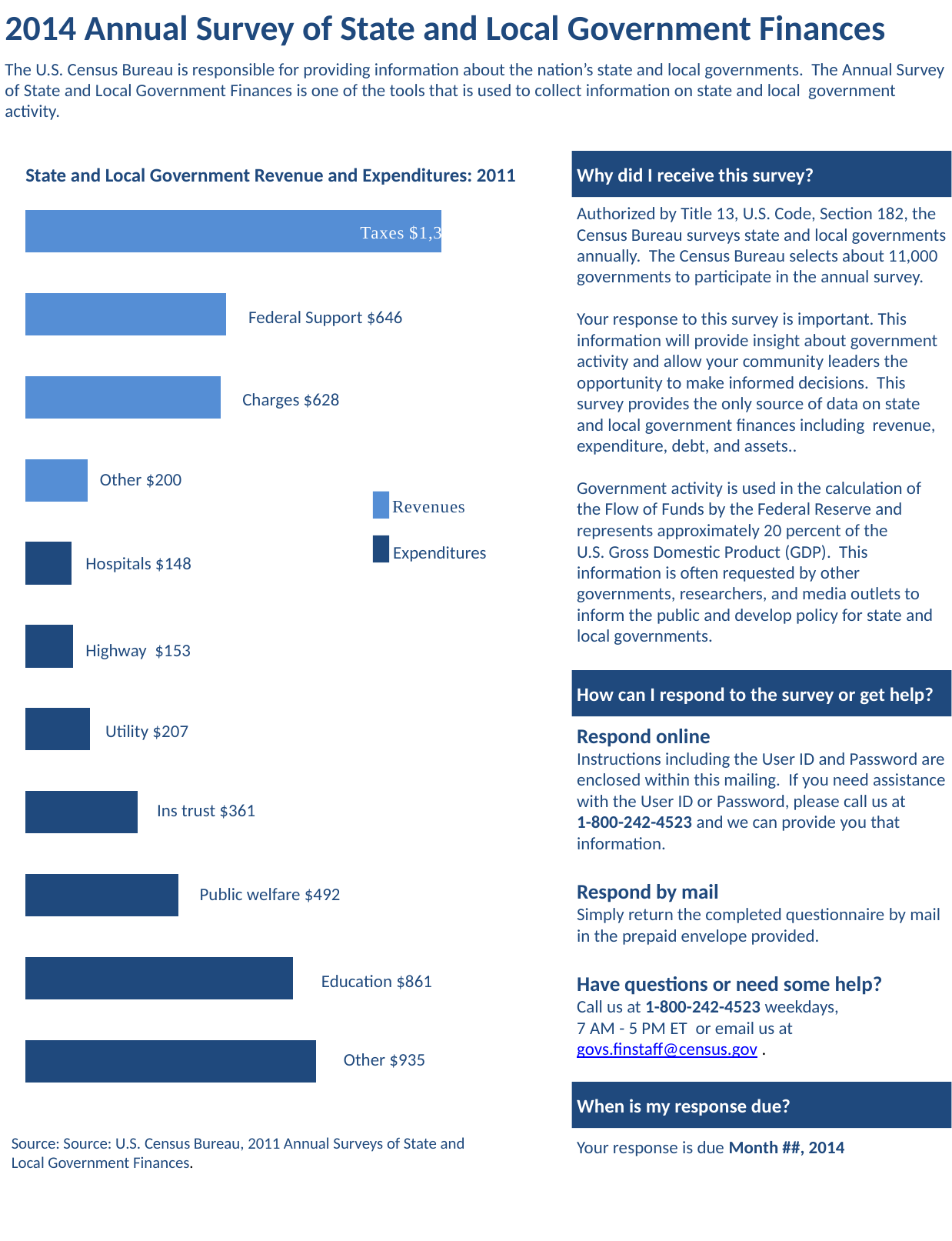
What is the value for Federal Support in the chart? $646 Which category has the longest bar in the chart? Taxes What type of chart is shown on the slide? Bar chart What is the value for Hospitals in the chart? $148 How many bars are shown in the chart? 11 What is the value for Education in the chart? $861 What is the value for Charges in the chart? $628 Which category has the smallest value in the chart? Hospitals Which is larger, the value for Ins trust or the value for Utility? Ins trust How many series does the chart legend list? 2 What is the title of the chart? State and Local Government Revenue and Expenditures: 2011 What is the difference between the Education value and the Public welfare value? $369